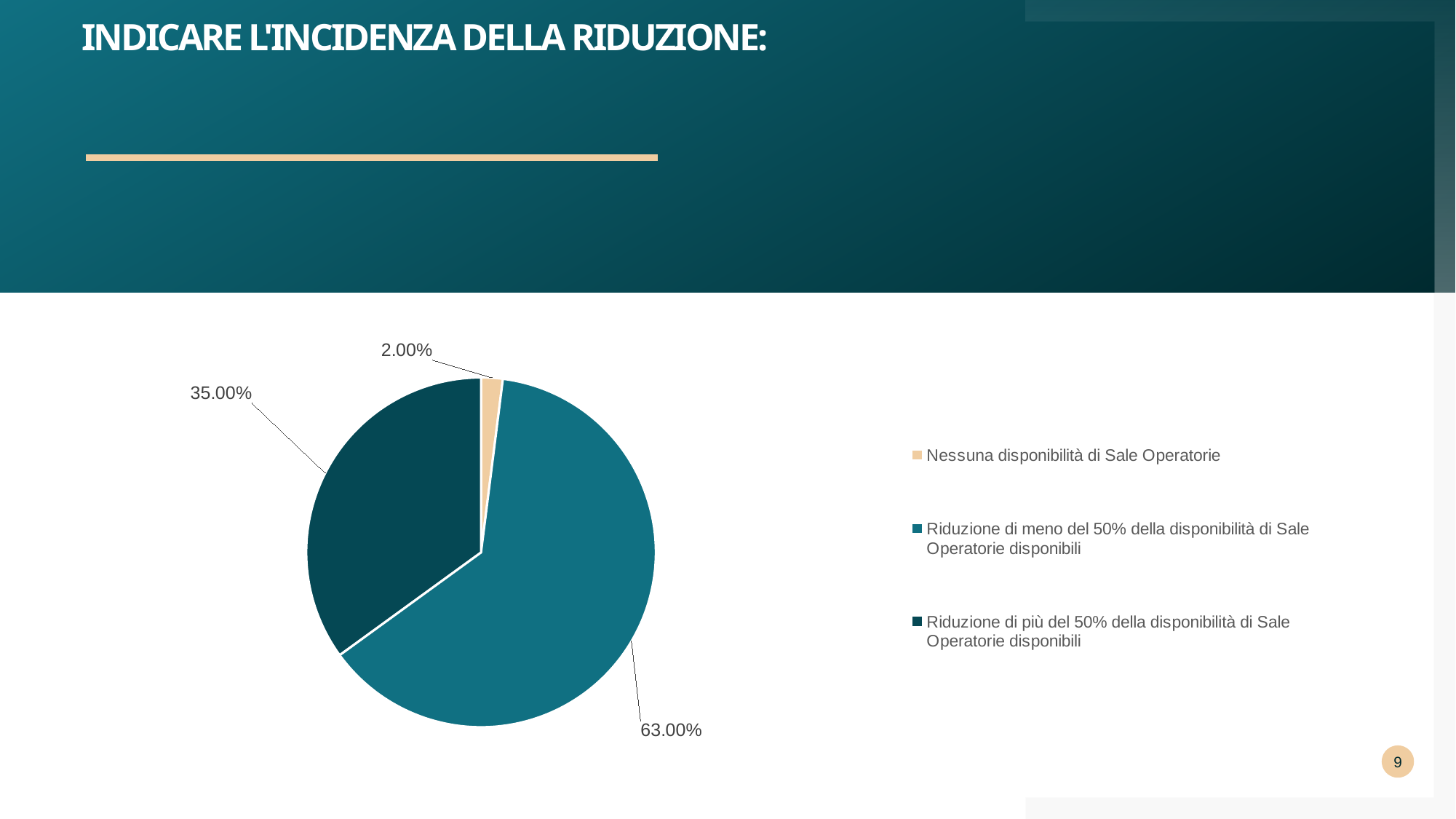
What is the difference in percentage points between the 'Riduzione di meno del 50%' slice and the 'Riduzione di più del 50%' slice? 28.00% What share of the pie is labelled 'Riduzione di più del 50% della disponibilità di Sale Operatorie disponibili'? 35.00% What kind of chart is shown on the slide? pie chart How many slices does the pie chart have? 3 How many entries does the legend list? 3 Which category has the smallest slice of the pie? Nessuna disponibilità di Sale Operatorie What share of the pie is labelled 'Nessuna disponibilità di Sale Operatorie'? 2.00% What share of the pie is labelled 'Riduzione di meno del 50% della disponibilità di Sale Operatorie disponibili'? 63.00% What is the combined share of the two 'Riduzione' slices? 98.00% Which category has the largest slice of the pie? Riduzione di meno del 50% della disponibilità di Sale Operatorie disponibili Which is larger: the 'Riduzione di più del 50%' slice or the 'Nessuna disponibilità di Sale Operatorie' slice? Riduzione di più del 50% della disponibilità di Sale Operatorie disponibili What colour is the slice for 'Nessuna disponibilità di Sale Operatorie'? beige